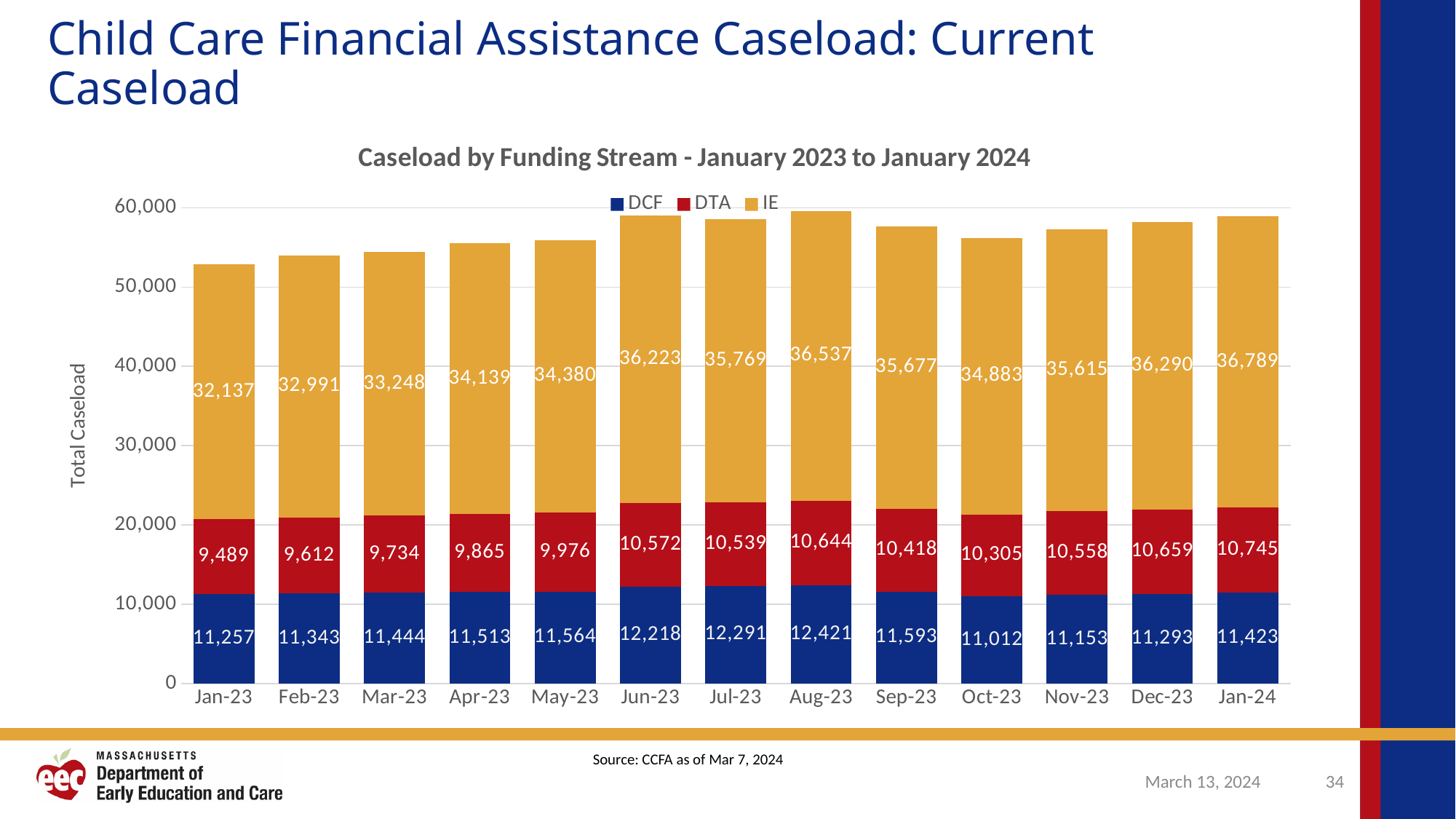
What is the difference between the IE value for Jan-24 and the IE value for Jan-23? 4,652 How many series does the legend list? 3 How many months are shown on the x axis? 13 Is the total stacked bar for Aug-23 greater or less than 50,000? greater Which is larger, the DTA value for Jun-23 or the DTA value for Jul-23? Jun-23 Which month has the highest DCF value? Aug-23 What is the total caseload for Jan-24 (sum of DCF, DTA and IE)? 58,957 What kind of chart is shown on the slide? Stacked bar chart Which month has the lowest IE value? Jan-23 What is the DCF value for Mar-23? 11,444 What is the DTA value for Oct-23? 10,305 What is the IE value for Jun-23? 36,223